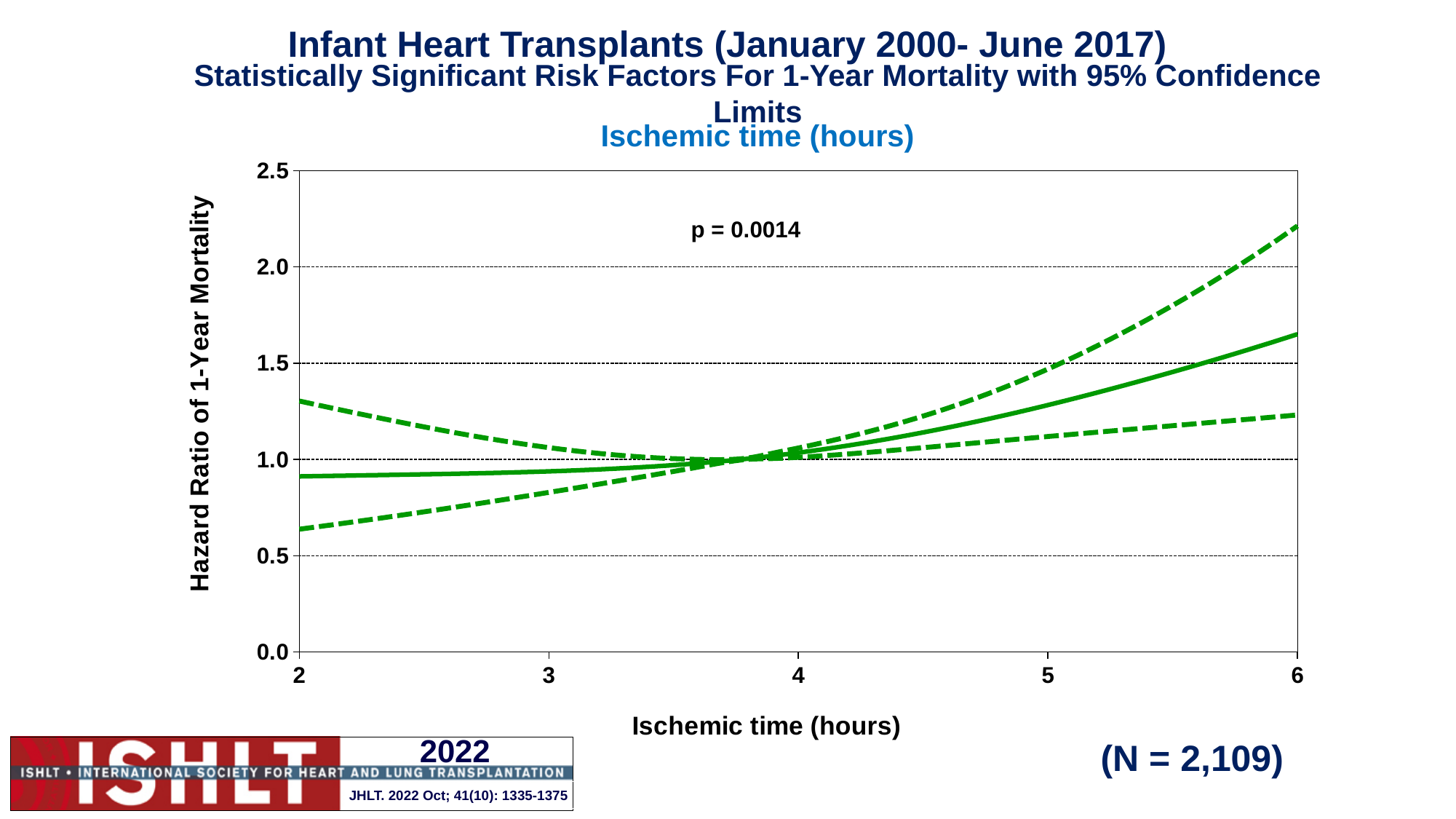
Is the lower 95% confidence limit (lower dashed line) at 2 hours greater or less than 0.5? greater What p-value is printed on the chart? p = 0.0014 How many lines are plotted on the chart? 3 Is the lower 95% confidence limit (lower dashed line) at 6 hours greater or less than 1.5? less Is the upper 95% confidence limit (upper dashed line) at 6 hours greater or less than 2.0? greater What kind of chart is shown on the slide? line chart Does the hazard ratio of 1-year mortality (solid line) rise or fall as ischemic time increases from 2 to 6 hours? rise What sample size (N) is shown on the slide? N = 2,109 Which is larger at 6 hours of ischemic time: the hazard ratio on the solid line or the hazard ratio on the upper dashed line? upper dashed line Which is larger on the solid line: the hazard ratio at 2 hours or the hazard ratio at 6 hours? 6 hours